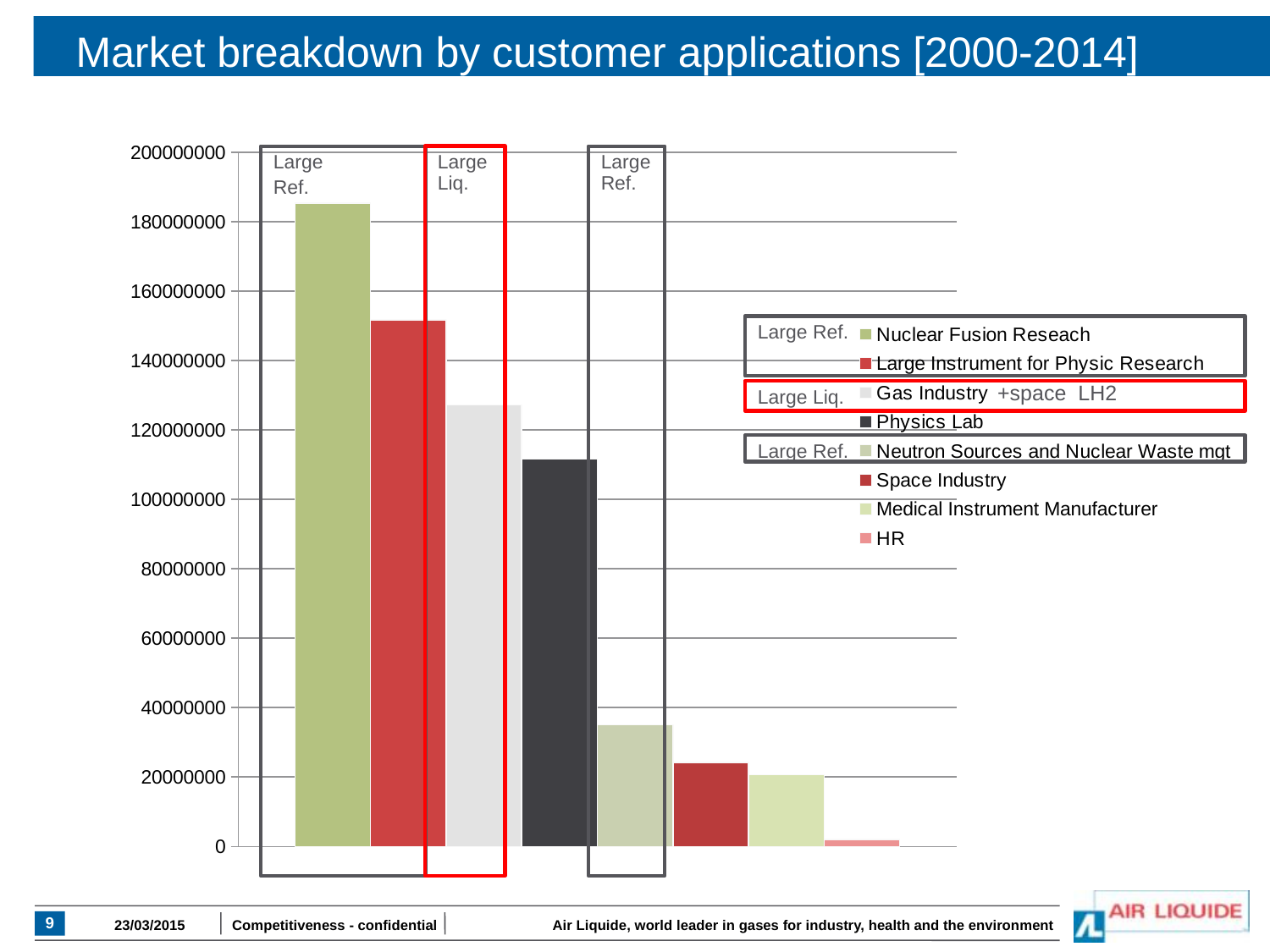
What is the title of the slide? Market breakdown by customer applications [2000-2014] Which series has the lowest value? HR Do the bar values rise or fall from left to right across the chart? fall Which series has the highest value? Nuclear Fusion Reseach What kind of chart is shown on the slide? bar chart Which is larger, the value for Physics Lab or the value for Space Industry? Physics Lab Is the value for Nuclear Fusion Reseach greater or less than 180000000? greater Is the value for HR greater or less than 20000000? less How many series does the legend list? 8 Is the value for Large Instrument for Physic Research greater or less than 140000000? greater